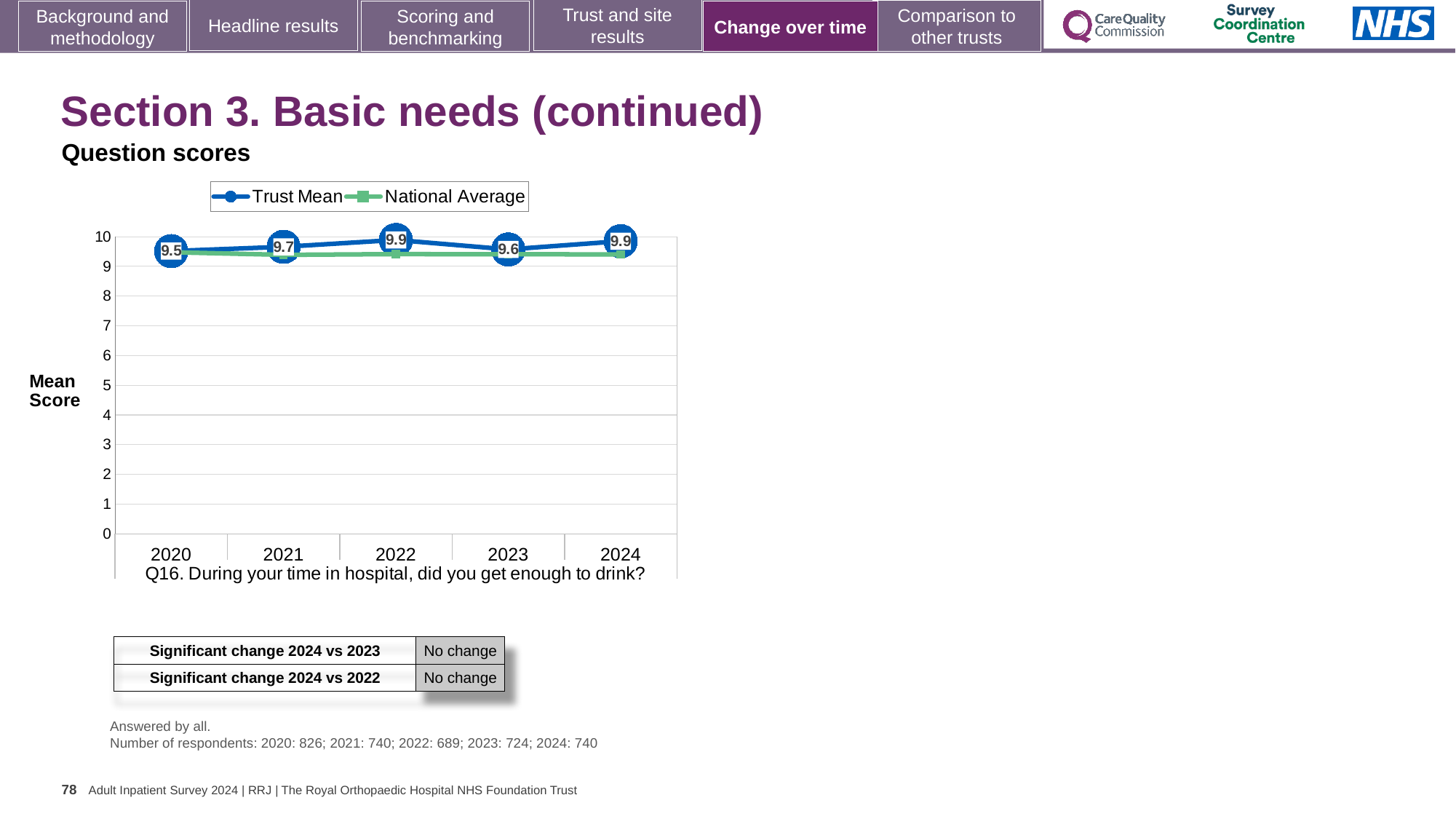
How many series does the legend list? 2 Does the Trust Mean rise or fall from 2020 to 2022? rise Is the National Average for 2020 greater or less than 9? greater How many years are plotted on the x axis? 5 Which is larger, the Trust Mean for 2021 or for 2023? 2021 What is the difference between the Trust Mean in 2024 and in 2023? 0.3 What is the difference between the Trust Mean in 2022 and in 2020? 0.4 What is the Trust Mean for 2024? 9.9 What kind of chart is shown? line chart What is the Trust Mean for 2023? 9.6 What is the Trust Mean for 2020? 9.5 Which year has the lowest Trust Mean? 2020